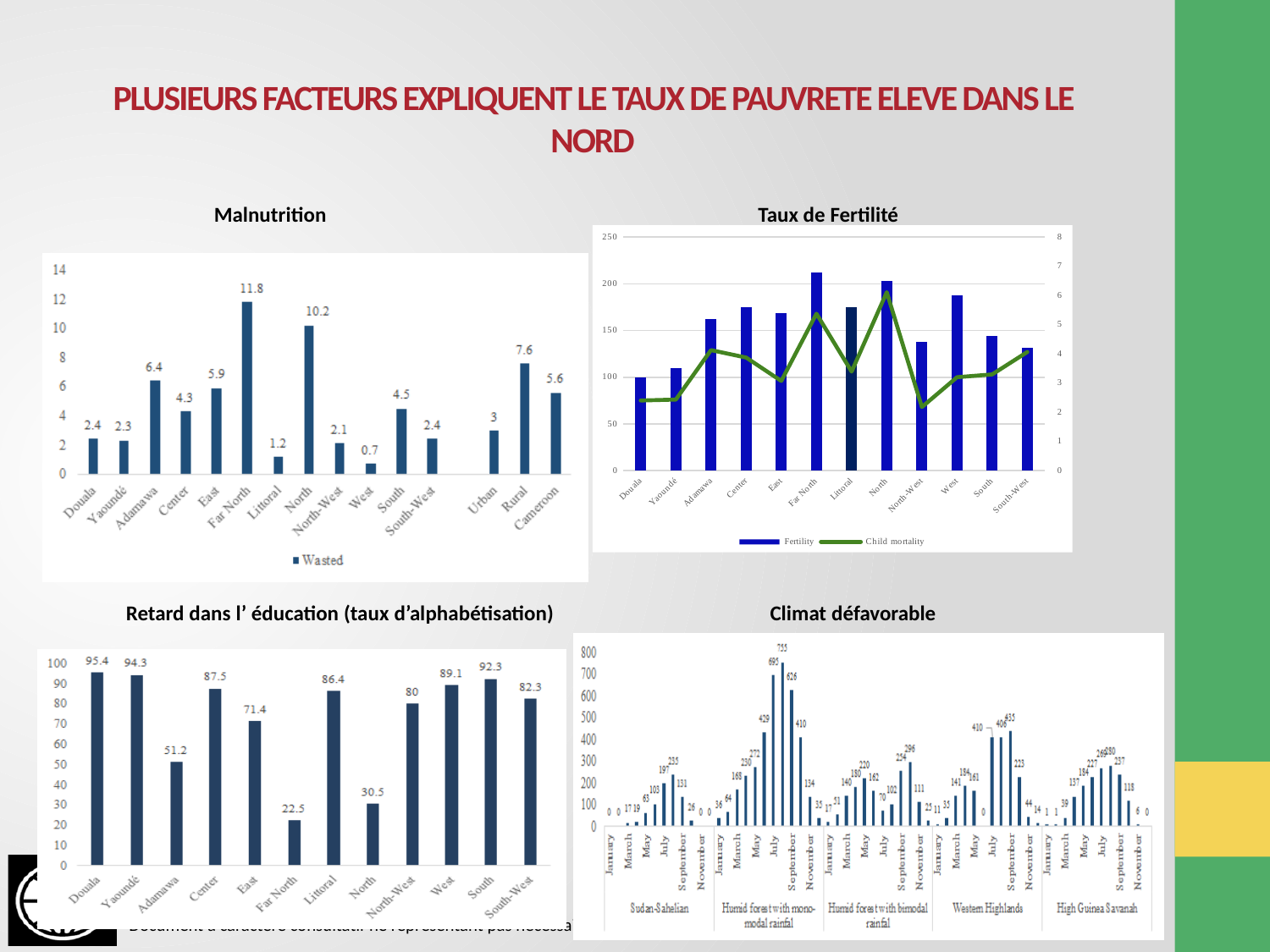
In the Taux de Fertilité chart, which region has the highest Fertility bar? Far North In the Taux de Fertilité chart, is the Fertility value for Far North greater or less than 200? greater In the Retard dans l'éducation chart, which region has the lowest literacy rate? Far North In the Retard dans l'éducation chart, what is the value for Douala? 95.4 In the Malnutrition chart, which region has the lowest value? West In the Retard dans l'éducation chart, how many regions are shown on the x axis? 12 In the Malnutrition chart, what series name does the legend show? Wasted In the Retard dans l'éducation chart, which is larger, the value for Center or the value for East? Center In the Malnutrition chart, what is the difference between the values for North and Adamawa? 3.8 In the Malnutrition chart, what is the value for Far North? 11.8 In the Taux de Fertilité chart, how many series does the legend list? 2 In the Malnutrition chart, what is the value for Rural? 7.6